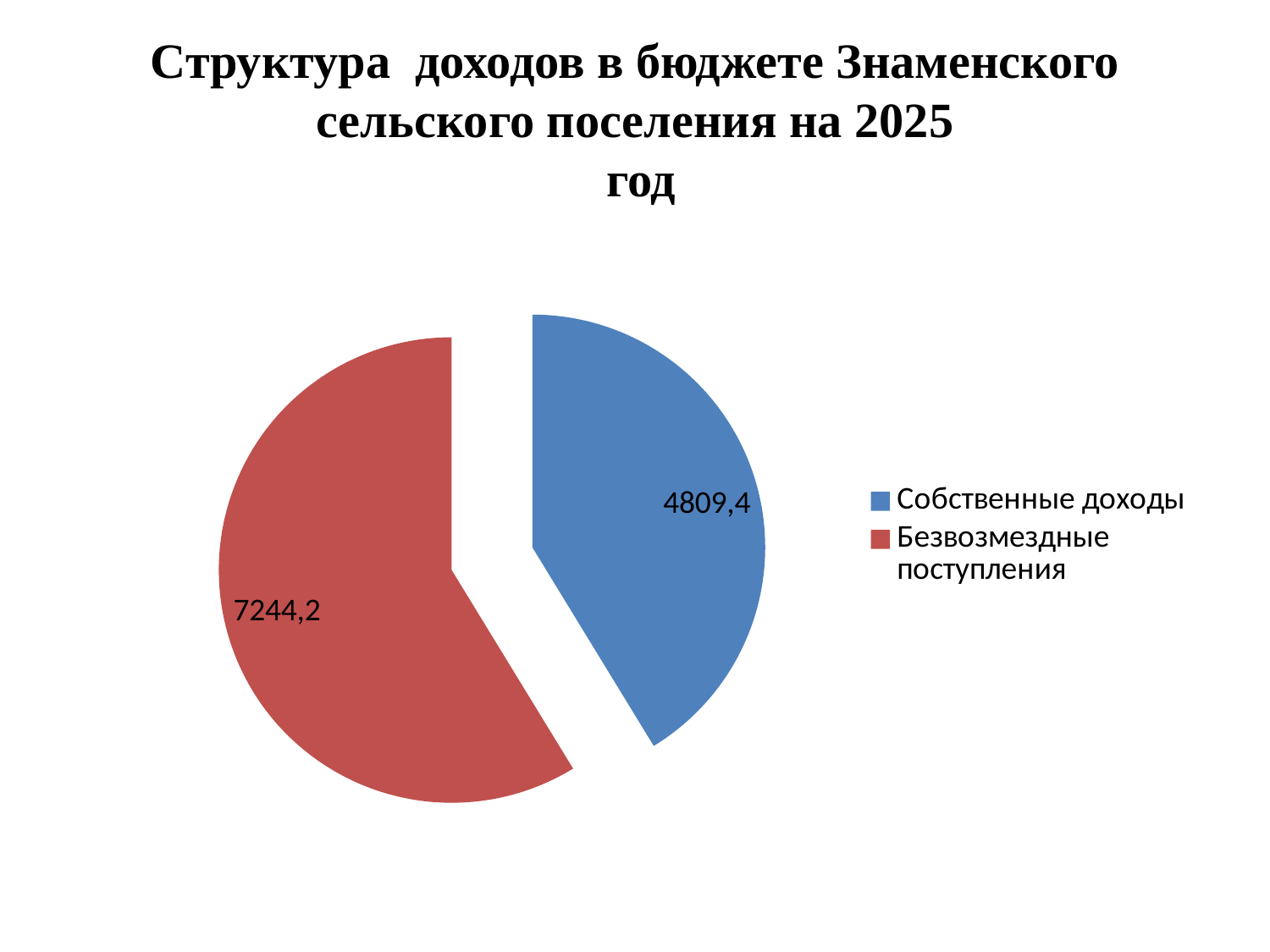
How many slices does the pie chart have? 2 What share of the total does Безвозмездные поступления represent? 60,1% What value is shown for Безвозмездные поступления? 7244,2 What is the difference between Безвозмездные поступления and Собственные доходы? 2434,8 How many entries does the legend list? 2 What kind of chart is shown on the slide? Pie chart What colour is the slice for Собственные доходы? Blue What is the total of the two slices in the pie chart? 12053,6 Which category has the largest slice of the pie? Безвозмездные поступления Which category has the smallest slice of the pie? Собственные доходы What value is shown for Собственные доходы? 4809,4 Which is larger, Собственные доходы or Безвозмездные поступления? Безвозмездные поступления